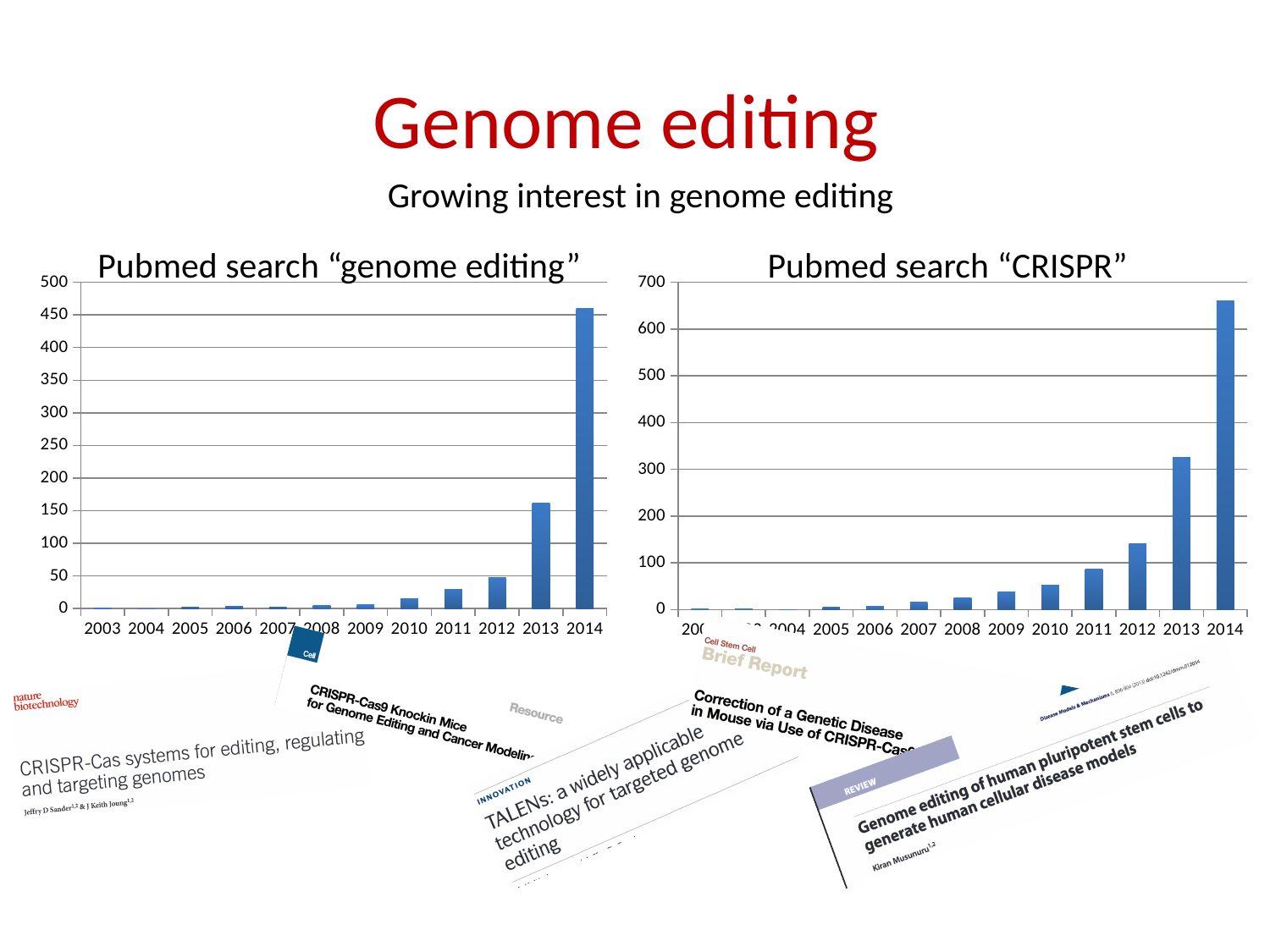
In the "Pubmed search "genome editing"" chart, is the value for 2014 greater or less than 400? greater In the "Pubmed search "genome editing"" chart, is the value for 2013 greater or less than 100? greater What kind of chart is the "Pubmed search "genome editing"" chart? bar chart In the "Pubmed search "CRISPR"" chart, which year has the highest value? 2014 In the "Pubmed search "genome editing"" chart, which is larger, the value for 2012 or the value for 2013? 2013 In the "Pubmed search "CRISPR"" chart, is the value for 2014 greater or less than 600? greater How many years are shown on the x axis of the "Pubmed search "genome editing"" chart? 12 In the "Pubmed search "genome editing"" chart, which year has the highest value? 2014 In the "Pubmed search "CRISPR"" chart, do the values generally rise or fall from 2005 to 2014? rise